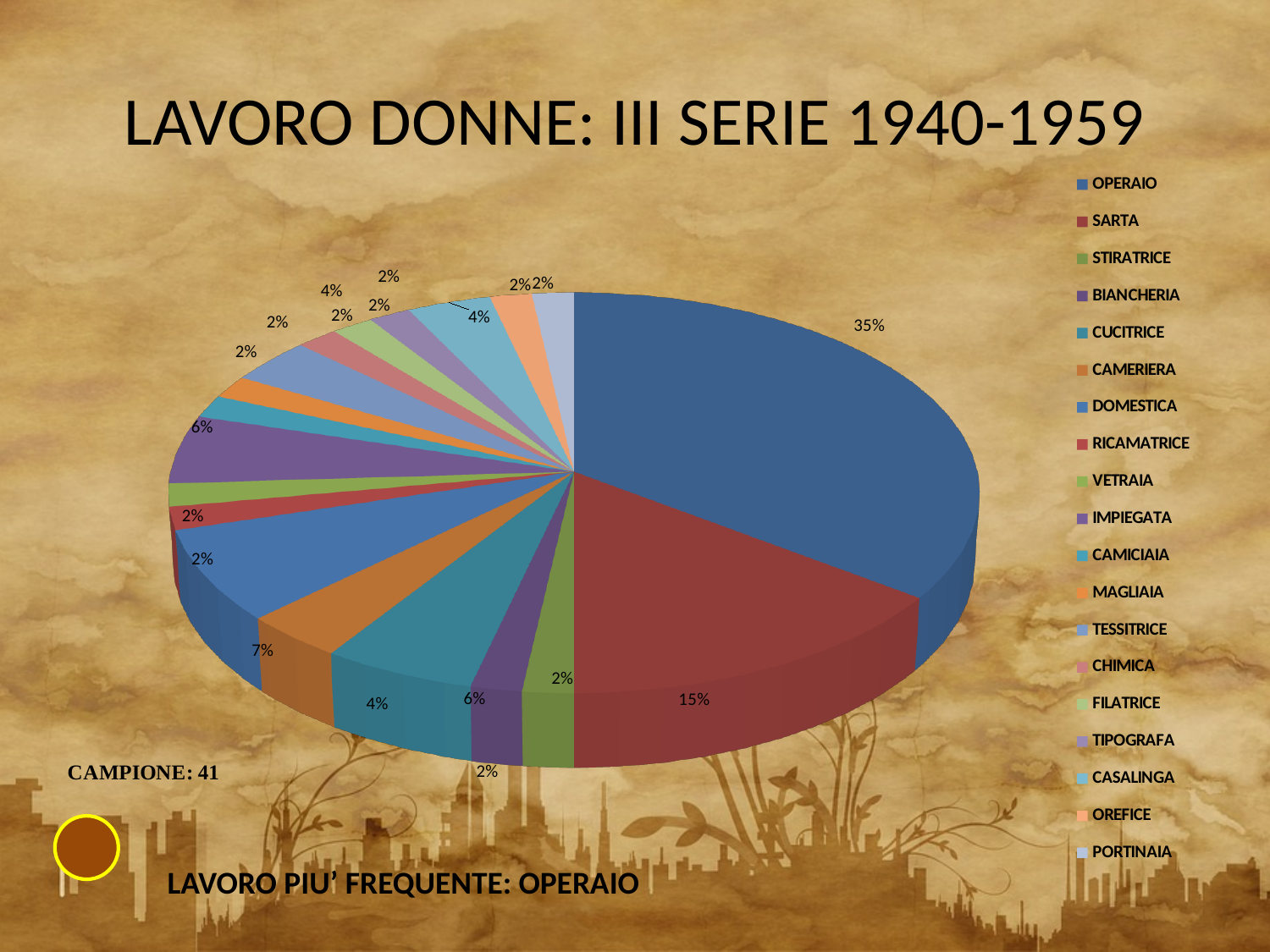
What percentage of the pie does SARTA represent? 15% What percentage of the pie does CUCITRICE represent? 6% Which category has the largest slice of the pie? OPERAIO What is the difference in percentage points between OPERAIO and SARTA? 20% Which is larger, the slice for OPERAIO or the slice for SARTA? OPERAIO What type of chart is shown on the slide? pie chart What is the title of the chart? LAVORO DONNE: III SERIE 1940-1959 What percentage of the pie does OPERAIO represent? 35% How many categories does the legend list? 19 What is the sample size (CAMPIONE) stated on the slide? 41